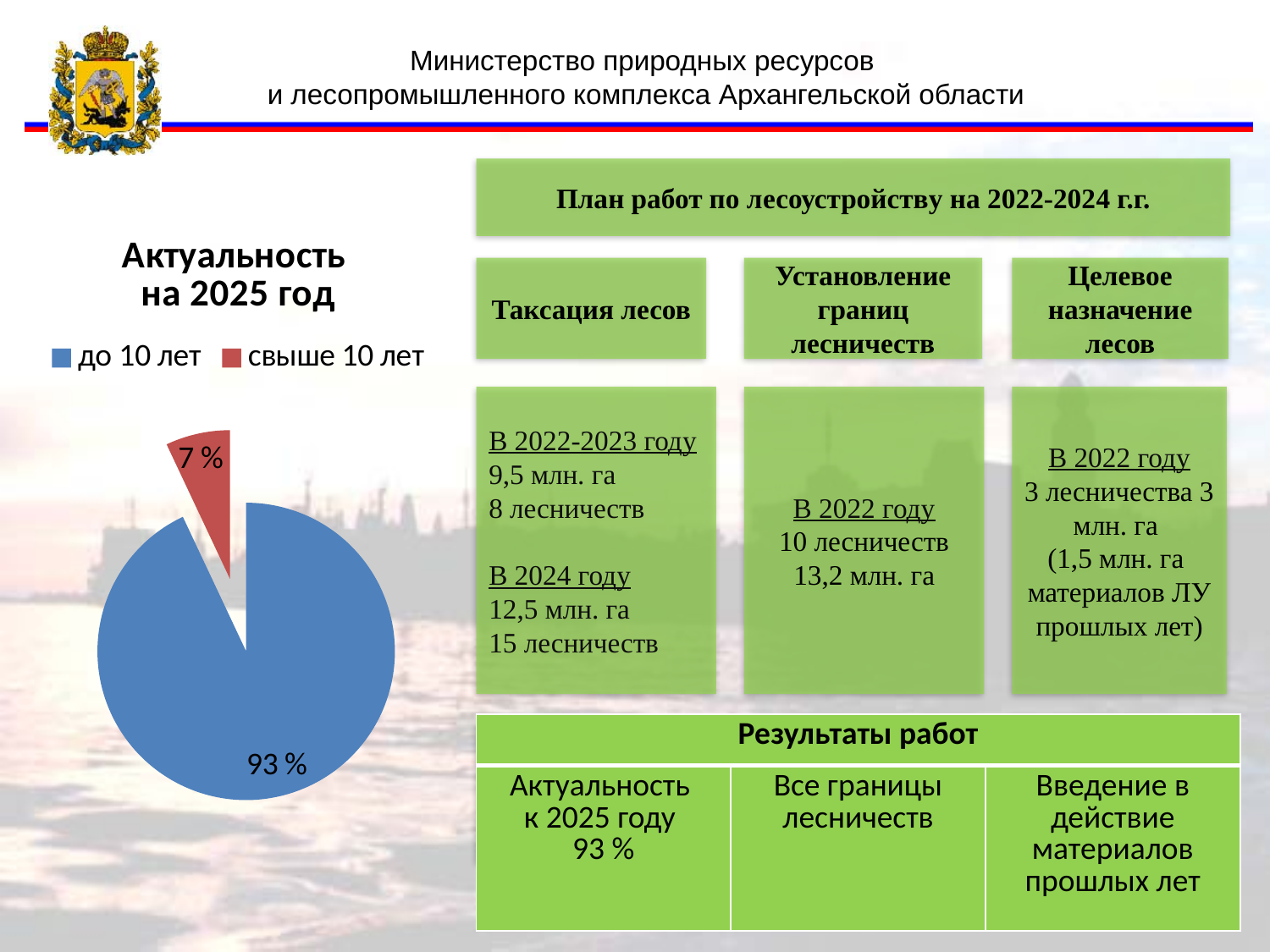
What share of the pie does the slice "свыше 10 лет" take? 7 % What share of the pie does the slice "до 10 лет" take? 93 % What is the title of the chart? Актуальность на 2025 год Which slice of the pie is the largest? до 10 лет Which slice of the pie is the smallest? свыше 10 лет Which is larger: the "до 10 лет" slice or the "свыше 10 лет" slice? до 10 лет How many slices does the pie chart have? 2 What is the difference in percentage points between the "до 10 лет" and "свыше 10 лет" slices? 86 What colour is the "свыше 10 лет" slice in the pie chart? red What kind of chart is shown on the slide? pie chart How many entries does the chart legend list? 2